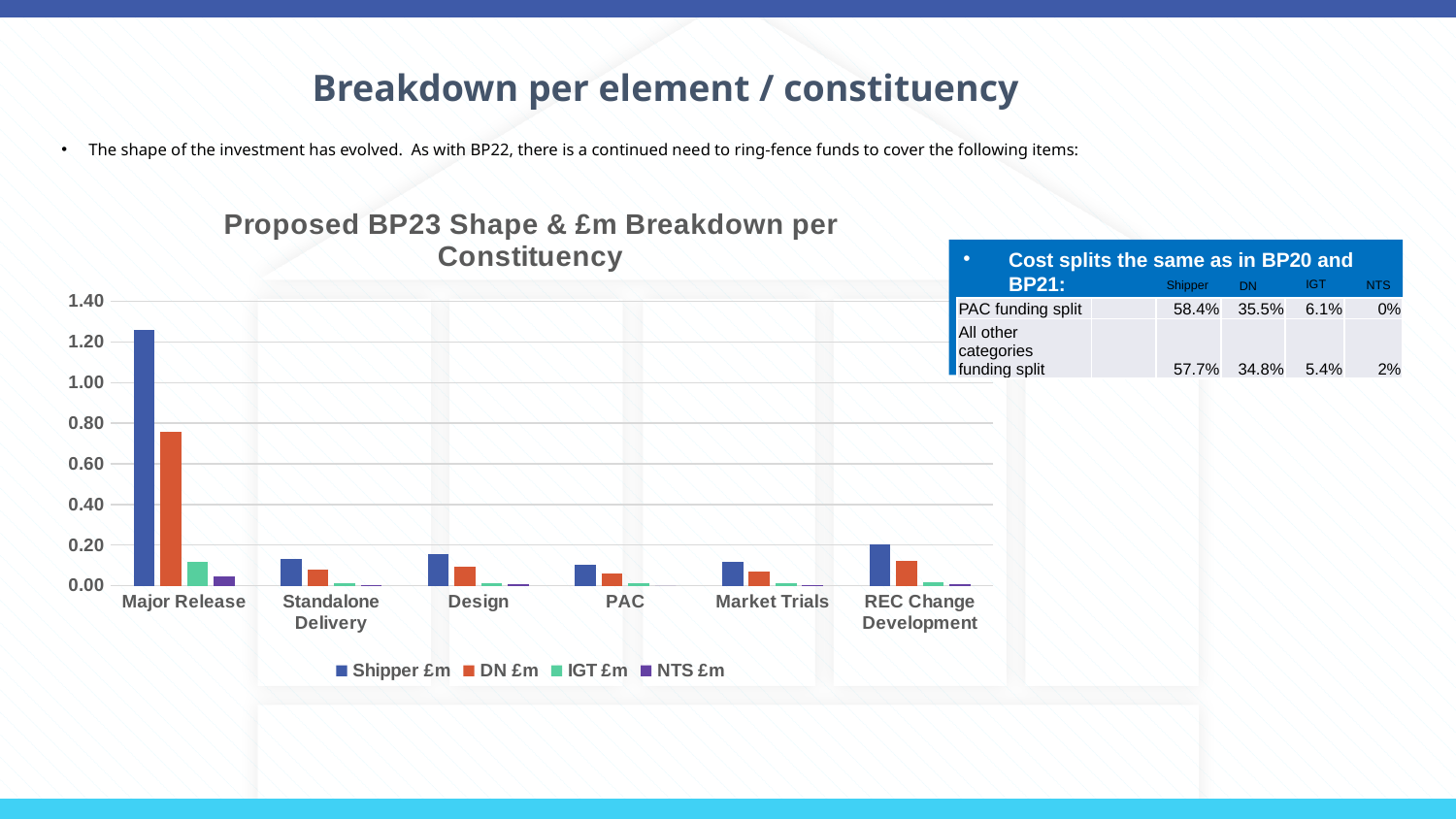
What is the title of the chart? Proposed BP23 Shape & £m Breakdown per Constituency How many categories are shown on the x axis of the chart? 6 Is the Shipper £m value for Major Release greater or less than 1.00? greater Which category has the highest Shipper £m value? Major Release What kind of chart is shown on the slide? bar chart Is the Shipper £m value for Design greater or less than 0.20? less Which is larger: the Shipper £m value for Major Release or the Shipper £m value for Design? Major Release Which category has the highest DN £m value? Major Release Is the DN £m value for Major Release greater or less than 0.60? greater How many series does the chart legend list? 4 For Major Release, which is larger: the Shipper £m value or the DN £m value? Shipper £m